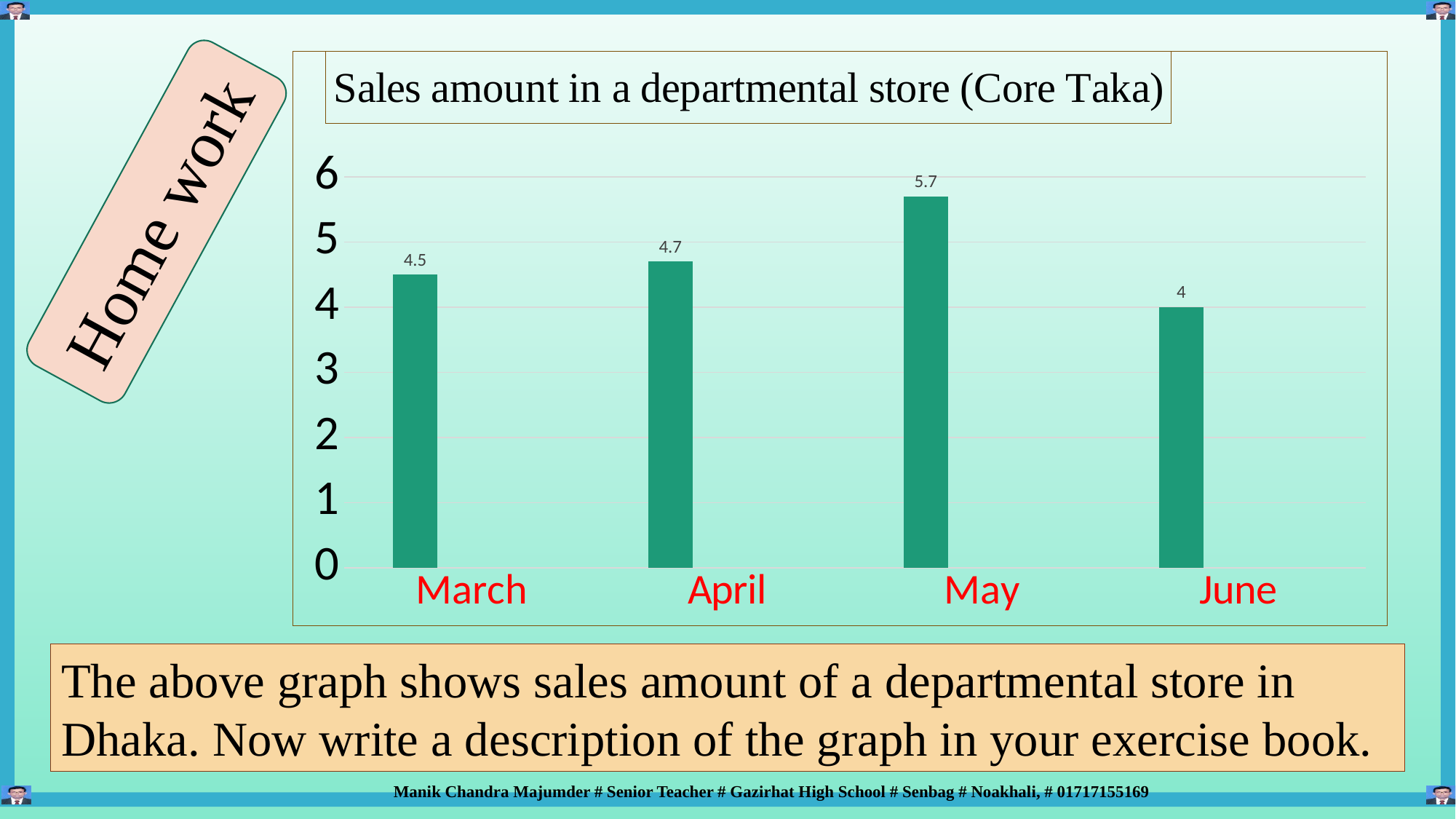
What is the title of the chart? Sales amount in a departmental store (Core Taka) What is the sales amount for May? 5.7 What is the difference between the sales amounts for April and March? 0.2 What is the sales amount for March? 4.5 Which month has a larger sales amount, April or June? April Which month has the highest sales amount? May Which month has the lowest sales amount? June How many months are shown on the chart? 4 What kind of chart is shown on the slide? Bar chart What is the difference between the sales amounts for May and June? 1.7 Is the value for May greater or less than 5? greater What is the sales amount for June? 4